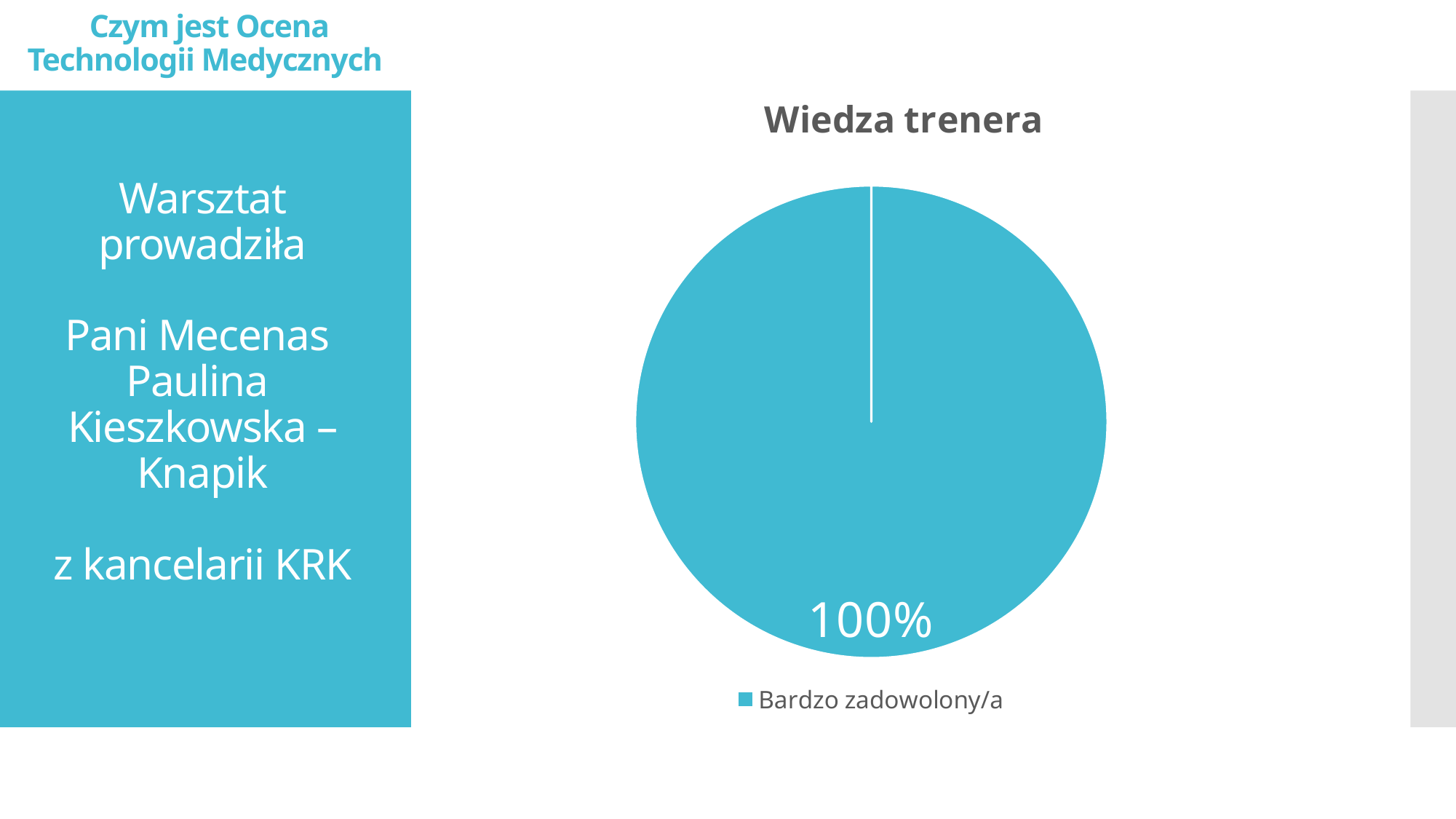
What share of the pie does the 'Bardzo zadowolony/a' slice represent? 100% What is the title of the chart? Wiedza trenera What value is printed on the 'Bardzo zadowolony/a' slice? 100% How many slices does the pie chart have? 1 Is the value for 'Bardzo zadowolony/a' greater or less than 50%? greater What is the legend entry shown below the pie chart? Bardzo zadowolony/a How many entries does the legend list? 1 What kind of chart is shown on the slide? pie chart